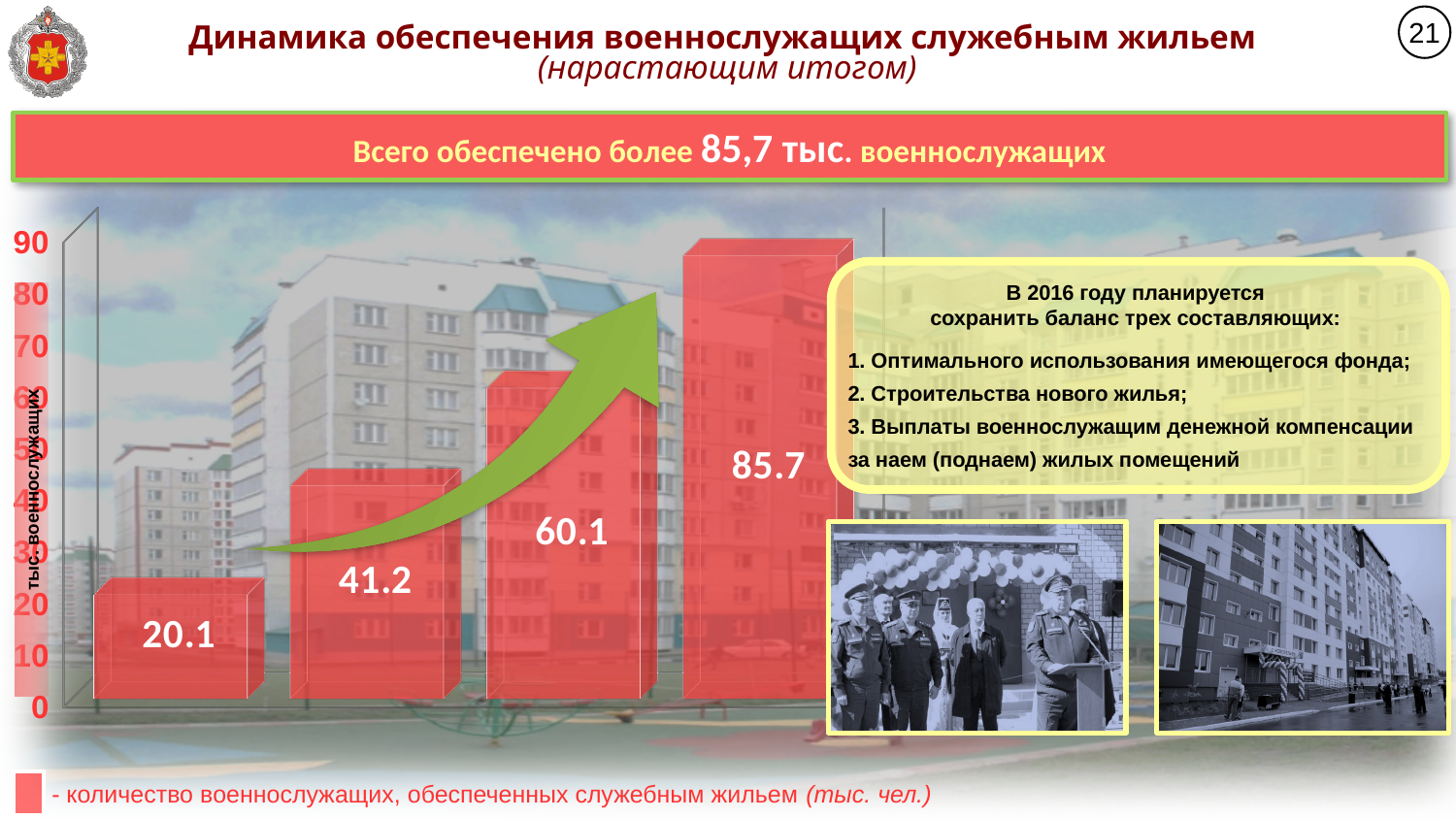
What is the difference between the third bar and the second bar? 18.9 What is the value of the rightmost bar in the chart? 85.7 Do the bar values rise or fall from left to right? Rise Which bar has the lowest value? The leftmost bar (20.1) What is the value of the third bar from the left? 60.1 What type of chart is shown on the slide? Bar chart Which bar has the highest value? The rightmost bar (85.7) Which is larger, the second bar or the third bar? The third bar (60.1) What is the value of the leftmost bar in the chart? 20.1 What is the value of the second bar from the left? 41.2 What is the difference between the rightmost bar and the leftmost bar? 65.6 How many bars are plotted in the chart? 4